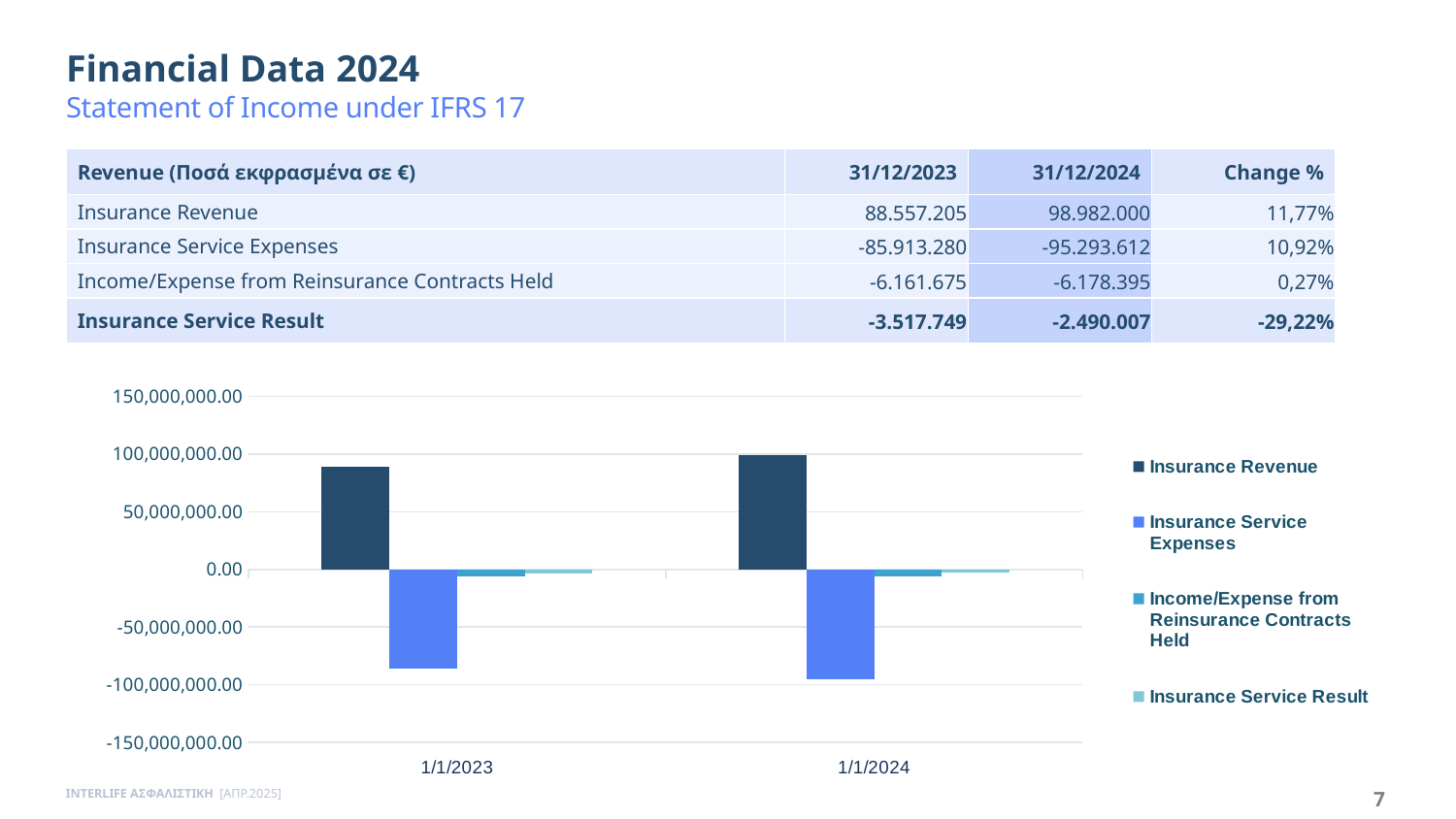
Is the Income/Expense from Reinsurance Contracts Held bar for 1/1/2023 greater or less than -50,000,000.00? greater How many series does the chart legend list? 4 Is the Insurance Service Expenses bar for 1/1/2024 greater or less than -50,000,000.00? less Which bar in the chart reaches the lowest (most negative) value? Insurance Service Expenses for 1/1/2024 Does Insurance Revenue rise or fall from 1/1/2023 to 1/1/2024 in the chart? rise How many categories are shown on the x axis of the chart? 2 What is the highest value shown on the chart's vertical axis? 150,000,000.00 Which is larger in the chart: Insurance Revenue for 1/1/2023 or Insurance Revenue for 1/1/2024? 1/1/2024 What kind of chart is shown on the slide? bar chart Which bar in the chart reaches the highest value? Insurance Revenue for 1/1/2024 Is the Insurance Revenue bar for 1/1/2023 greater or less than 50,000,000.00? greater